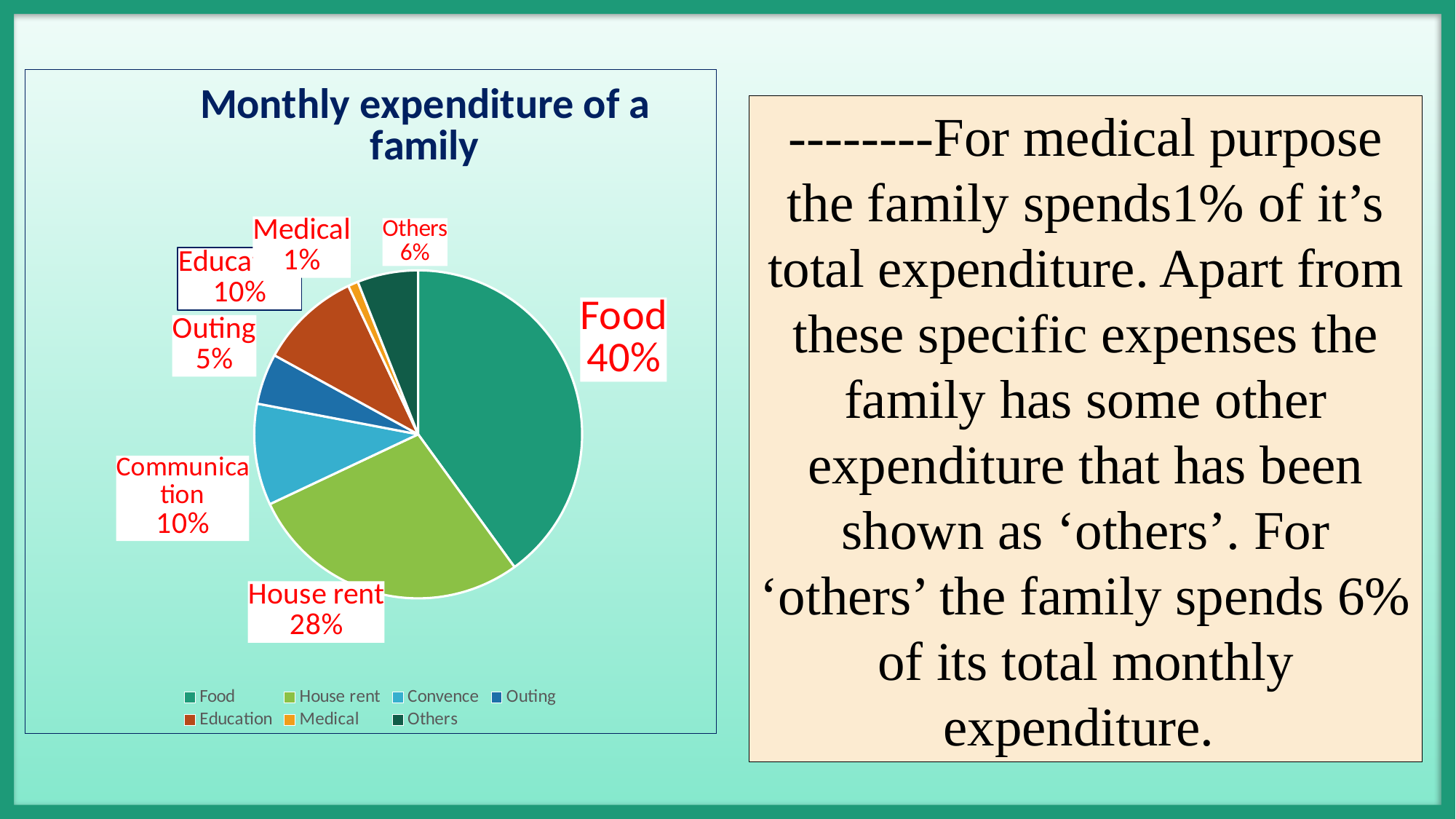
What is the title of the pie chart? Monthly expenditure of a family Which is larger, the share for Others or the share for Outing? Others What percentage of the monthly expenditure goes to Outing? 5% How many entries does the legend of the pie chart list? 7 What percentage of the monthly expenditure goes to House rent? 28% What percentage of the monthly expenditure goes to Food? 40% Which category has the largest share of the monthly expenditure? Food What percentage of the monthly expenditure goes to Medical? 1% What percentage of the monthly expenditure goes to Others? 6% How many percentage points larger is the Food share than the House rent share? 12% What kind of chart is shown on the slide? pie chart Which category has the smallest share of the monthly expenditure? Medical